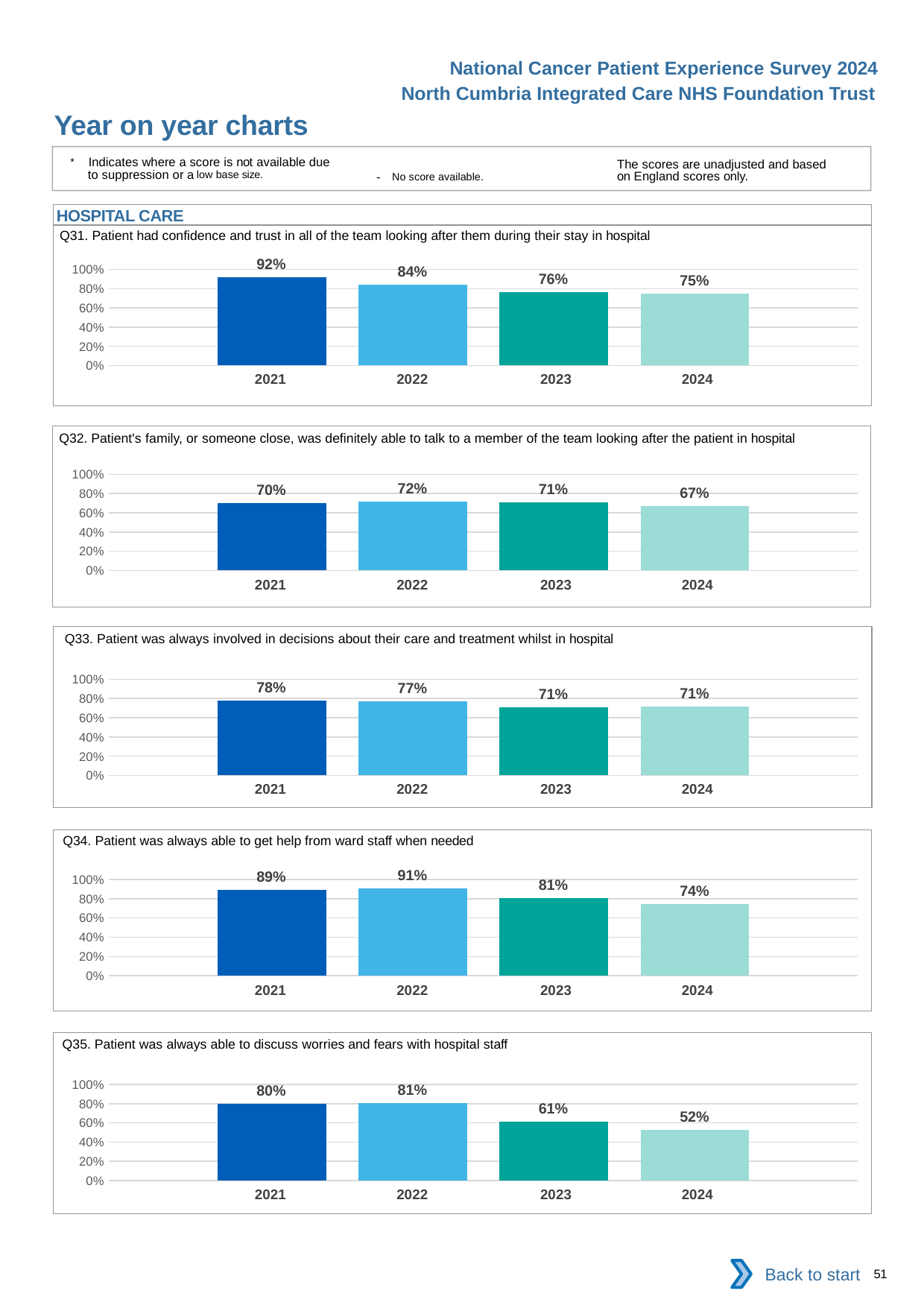
What kind of chart is the Q31 chart? bar chart In the Q32 chart, what is the difference between the 2022 and 2024 values? 5 percentage points In the Q32 chart, which year has the highest value? 2022 In the Q34 chart, what is the difference between the 2021 and 2024 values? 15 percentage points In the Q31 chart, which year has the lowest value? 2024 In the Q33 chart, which is larger, the value for 2021 or the value for 2022? 2021 In the Q31 chart, what is the value for 2021? 92% How many years are shown on the x axis of the Q35 chart? 4 In the Q35 chart, do the values rise or fall from 2022 to 2024? fall In the Q35 chart, what is the value for 2024? 52% In the Q33 chart, what is the value for 2024? 71% In the Q34 chart, what is the value for 2022? 91%